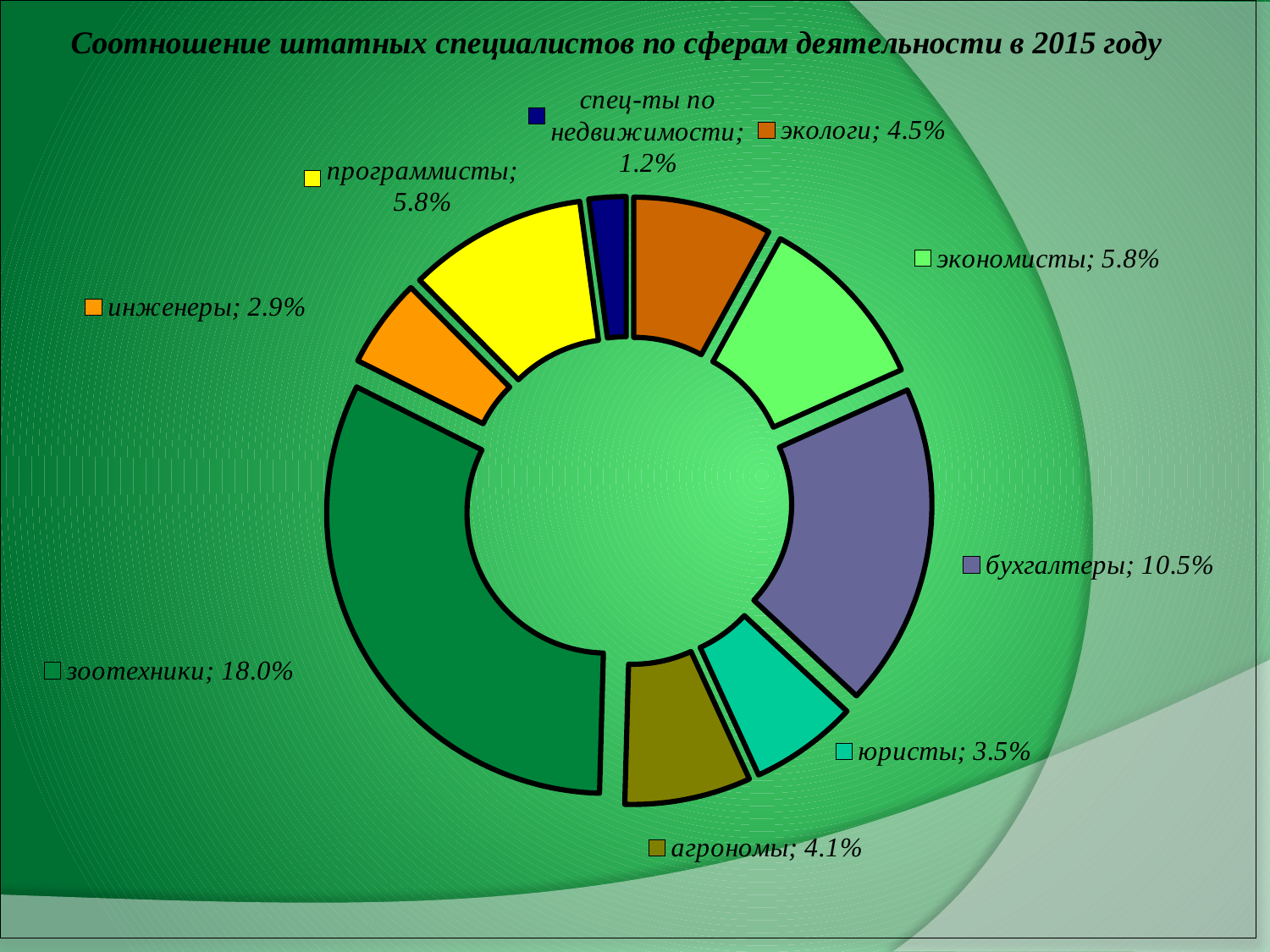
What is the title of the chart? Соотношение штатных специалистов по сферам деятельности в 2015 году What is the difference in percentage points between зоотехники and бухгалтеры? 7.5% Which has a larger share, инженеры or юристы? юристы Which has a larger share, экологи or агрономы? экологи What percentage is shown for юристы? 3.5% What percentage is shown for спец-ты по недвижимости? 1.2% Which category has the largest share in the chart? зоотехники How many categories are shown in the chart? 9 What percentage is shown for бухгалтеры? 10.5% What percentage is shown for зоотехники? 18.0% What kind of chart is shown on the slide? doughnut chart Which category has the smallest share in the chart? спец-ты по недвижимости